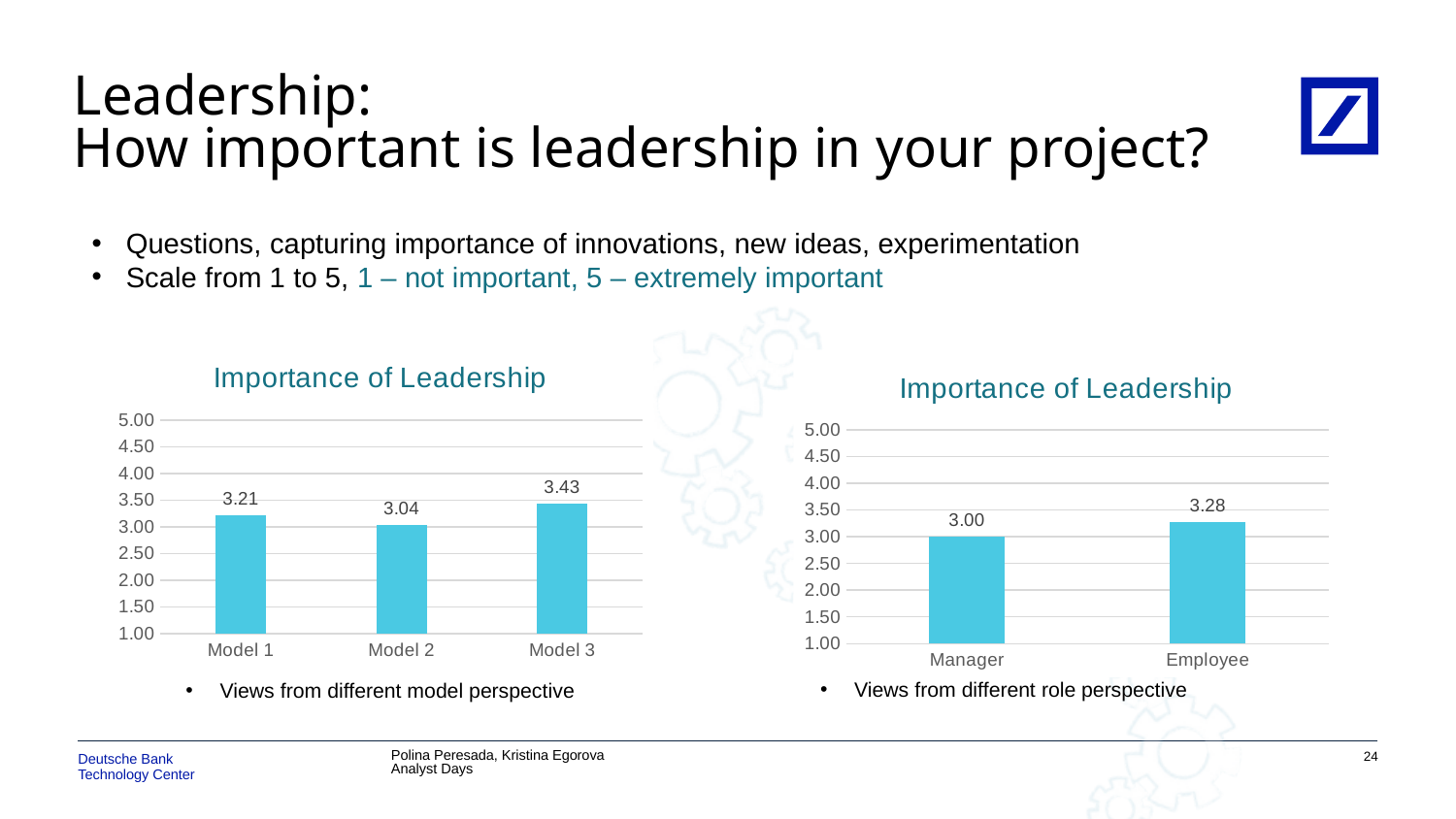
In the left chart (model perspective), what is the value for Model 2? 3.04 In the left chart (model perspective), what is the difference between the values for Model 3 and Model 2? 0.39 In the right chart (role perspective), which role rates leadership as more important, Manager or Employee? Employee In the right chart (role perspective), what is the value for Employee? 3.28 In the right chart (role perspective), what is the difference between the Employee and Manager values? 0.28 What type of chart is the right chart (role perspective)? Bar chart In the right chart (role perspective), what is the value for Manager? 3.00 In the left chart (model perspective), what is the value for Model 1? 3.21 In the left chart (model perspective), which model has the highest importance of leadership? Model 3 In the left chart (model perspective), how many models are shown? 3 What is the title of the left chart? Importance of Leadership In the left chart (model perspective), which model has the lowest importance of leadership? Model 2